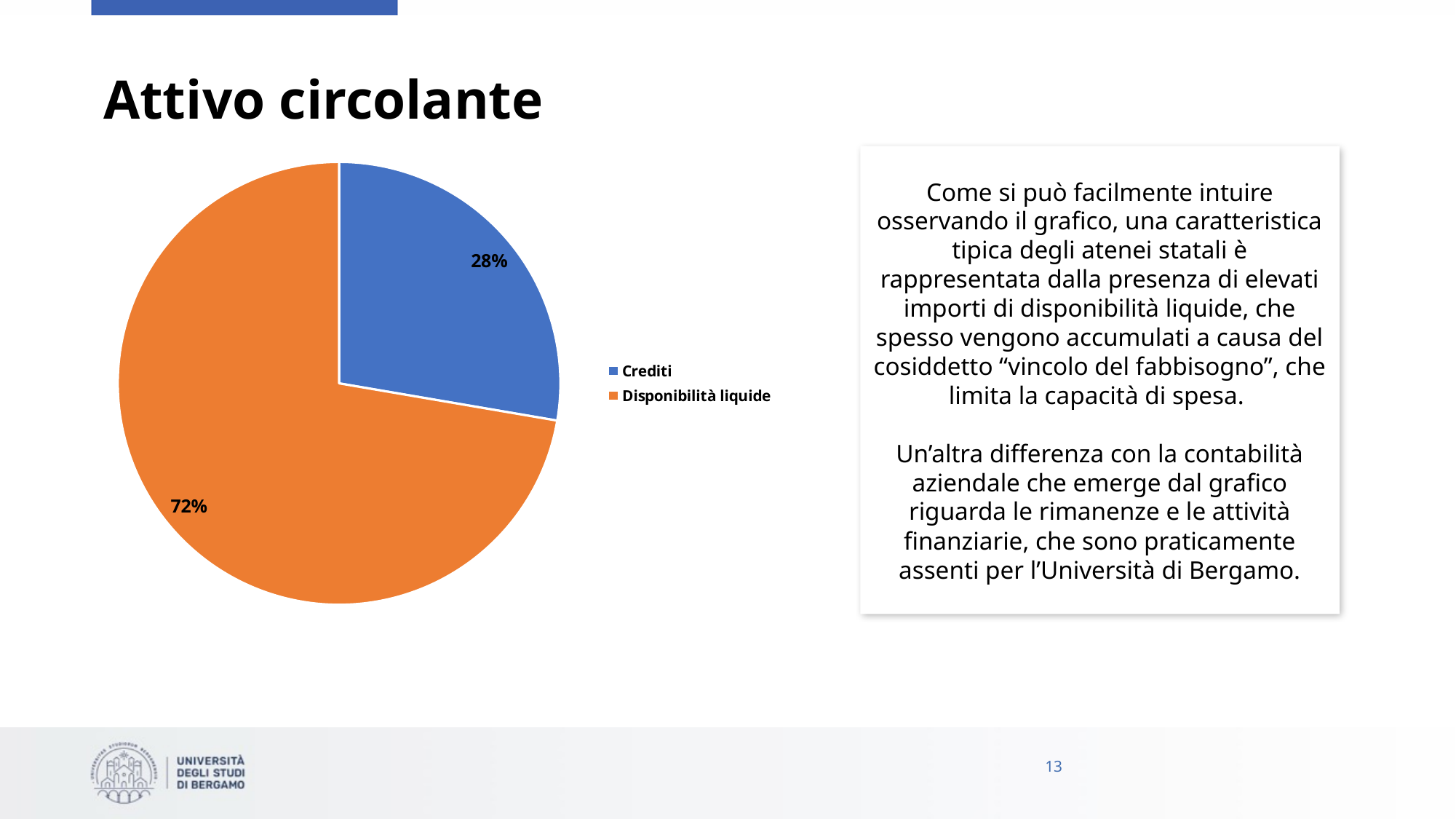
Which is larger, Crediti or Disponibilità liquide? Disponibilità liquide How many entries does the legend list? 2 How many categories are shown in the pie chart? 2 What colour is the Disponibilità liquide slice? Orange What is the difference in percentage points between Disponibilità liquide and Crediti? 44 What colour is the Crediti slice? Blue Which category has the largest slice of the pie? Disponibilità liquide What share of the pie does Disponibilità liquide represent? 72% What share of the pie does Crediti represent? 28% What kind of chart is shown on the slide? Pie chart Which category has the smallest slice of the pie? Crediti